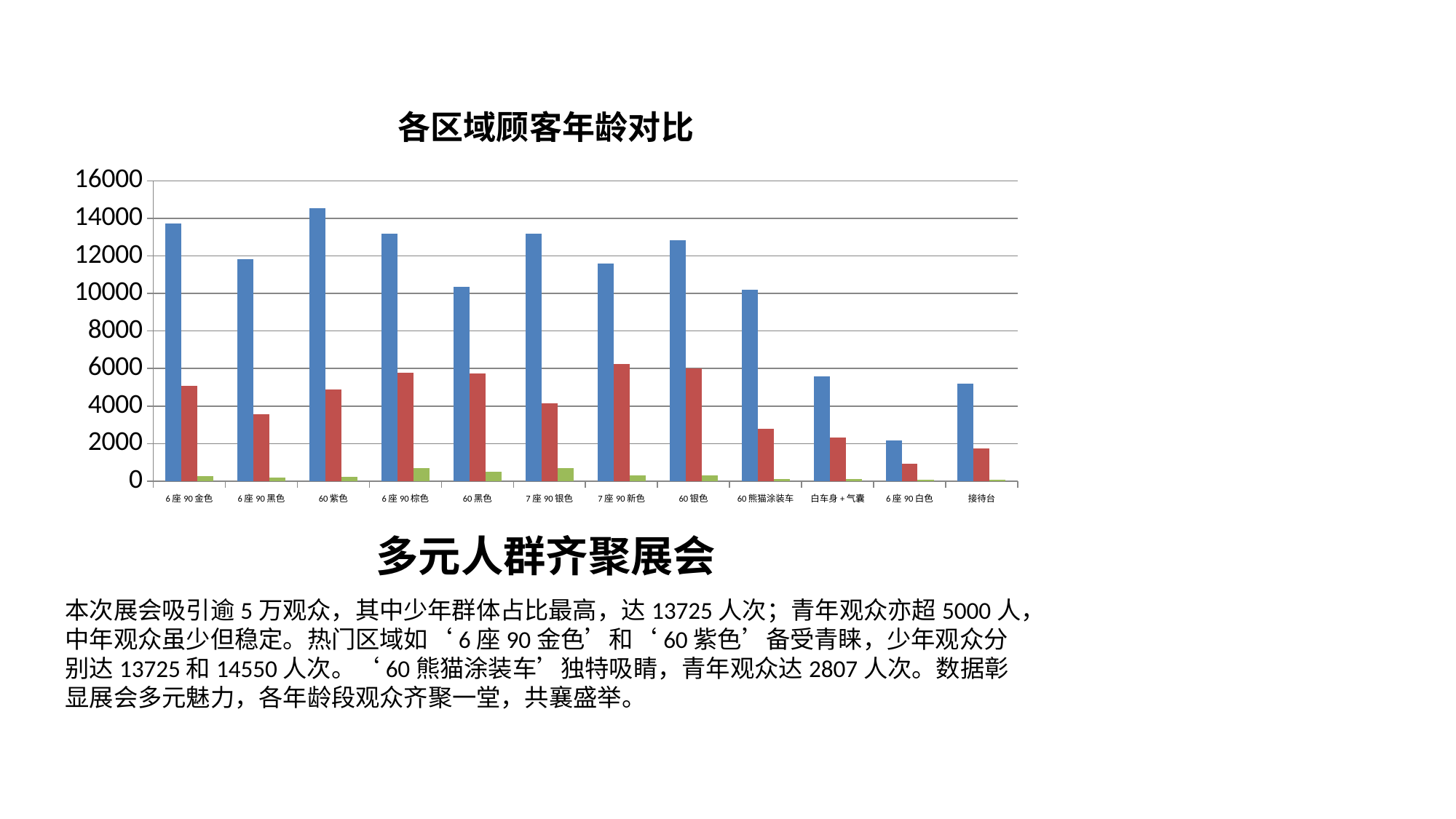
Is the blue bar for 白车身 + 气囊 greater or less than 8000? less What kind of chart is shown on the slide? bar chart Is the red bar for 6 座 90 白色 greater or less than 2000? less Which category has the tallest blue bar? 60 紫色 Which has the taller red bar, 60 银色 or 60 熊猫涂装车? 60 银色 Is the red bar for 7 座 90 新色 greater or less than 4000? greater Which category has the shortest blue bar? 6 座 90 白色 How many categories are shown along the x axis of the chart? 12 Which has the taller blue bar, 6 座 90 黑色 or 60 黑色? 6 座 90 黑色 Which colour of bar is the tallest in every category of the chart? blue What is the title of the chart? 各区域顾客年龄对比